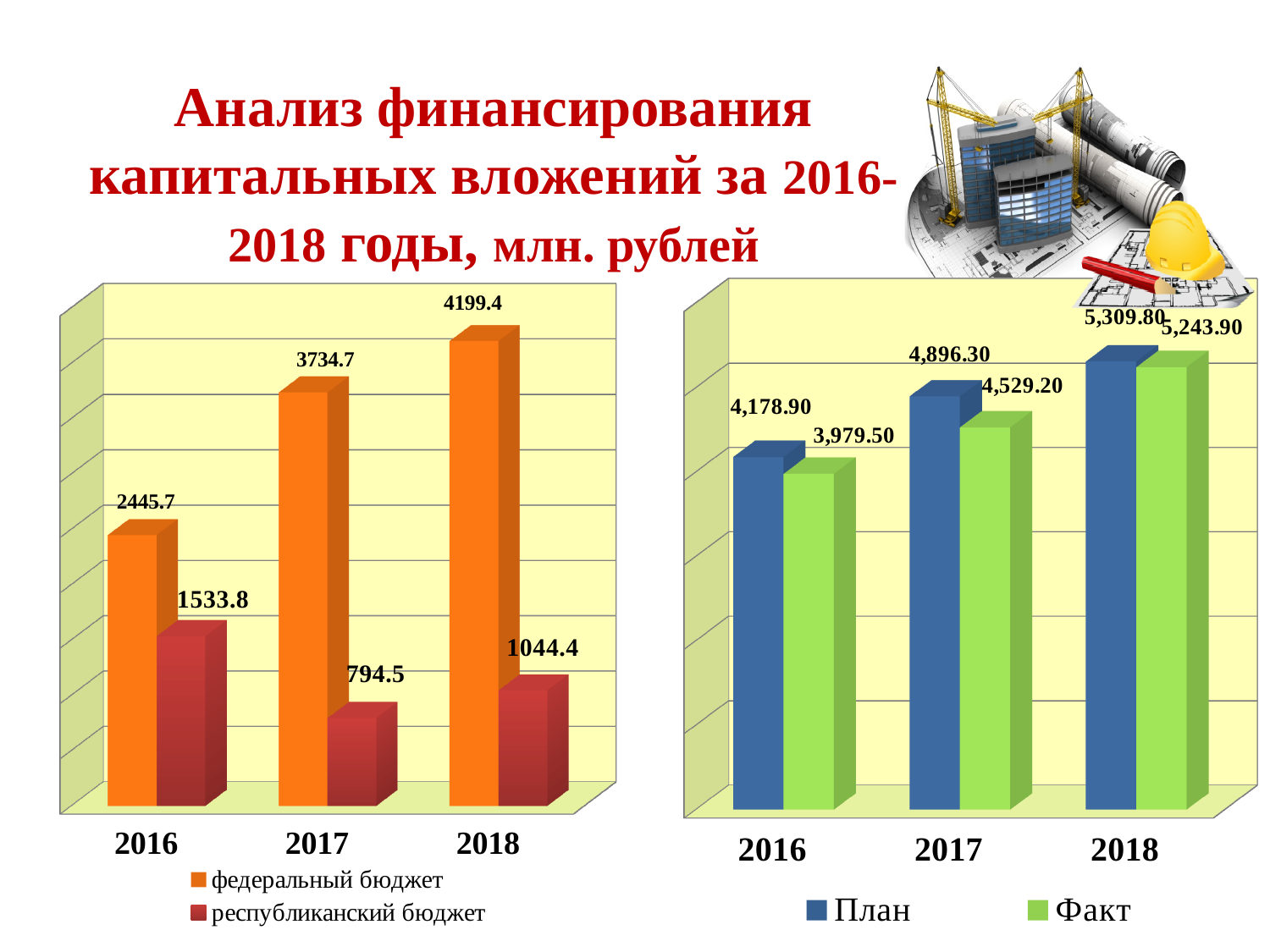
On the right chart, what is the difference between План and Факт in 2017? 367.10 On the left chart, what is the value for республиканский бюджет in 2017? 794.5 On the left chart, how many series does the legend list? 2 On the right chart, what is the Факт value for 2016? 3,979.50 On the left chart, what is the value for федеральный бюджет in 2018? 4199.4 What kind of chart is the right chart? bar chart On the left chart, what is the difference between федеральный бюджет and республиканский бюджет in 2018? 3155.0 On the right chart, which is larger in 2016, План or Факт? План On the right chart, in which year is the Факт value highest? 2018 On the left chart, does the федеральный бюджет value rise or fall from 2016 to 2018? rise On the right chart, what is the План value for 2017? 4,896.30 On the left chart, in which year is the республиканский бюджет value lowest? 2017